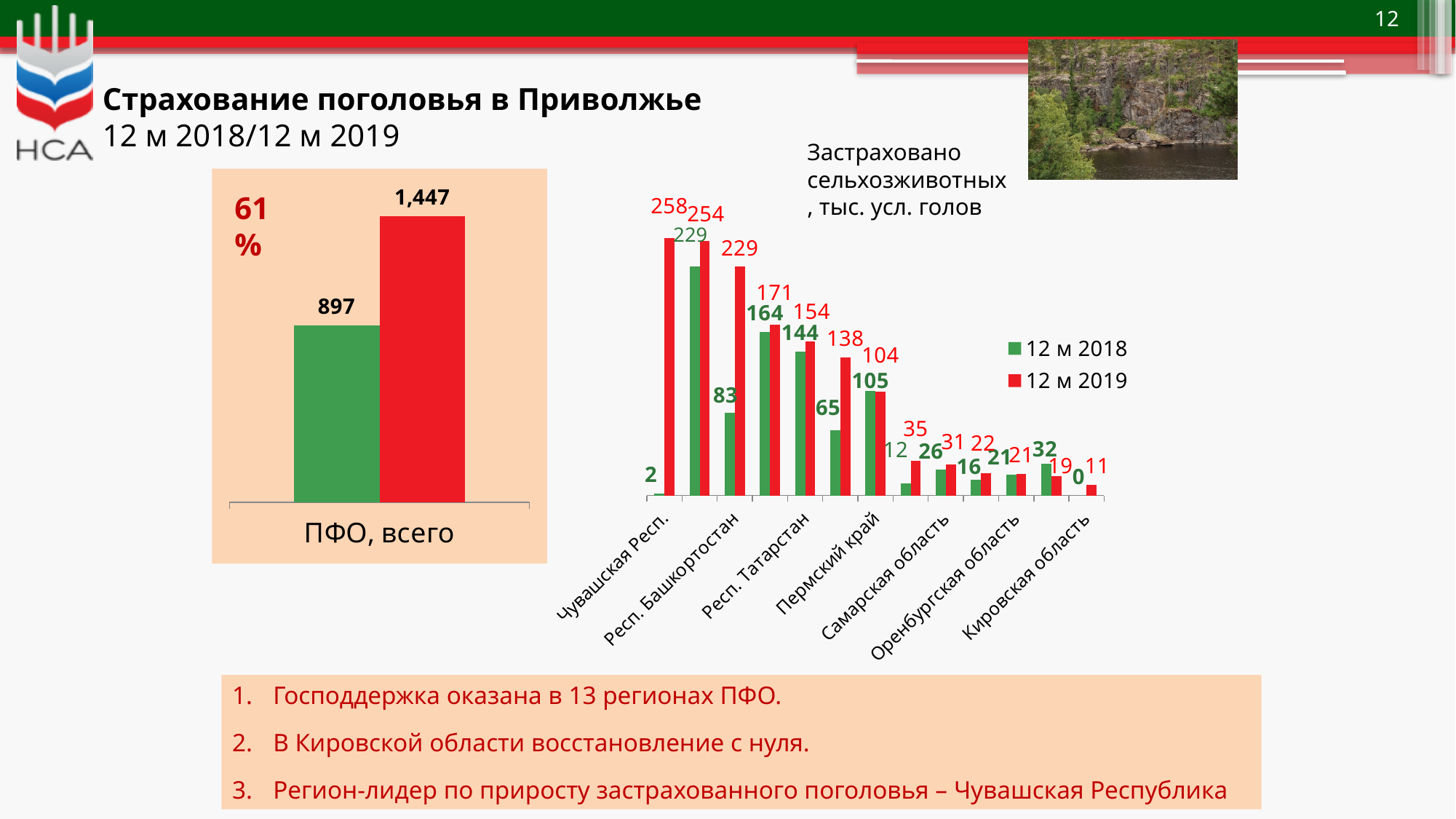
In the left chart (ПФО, всего), what is the value for 12 м 2018? 897 In the left chart (ПФО, всего), what is the value for 12 м 2019? 1,447 What percentage is printed in the left chart (ПФО, всего)? 61 % In the right chart (Застраховано сельхозживотных), what are the two legend entries? 12 м 2018 and 12 м 2019 In the left chart (ПФО, всего), what is the difference between the 12 м 2019 value and the 12 м 2018 value? 550 In the left chart (ПФО, всего), which is larger: the 12 м 2018 value or the 12 м 2019 value? 12 м 2019 What kind of chart is the right chart (Застраховано сельхозживотных)? bar chart In the right chart (Застраховано сельхозживотных), what is the 12 м 2018 value for Кировская область? 0 In the right chart (Застраховано сельхозживотных), what is the 12 м 2018 value for Чувашская Респ.? 2 In the right chart (Застраховано сельхозживотных), which region has the highest 12 м 2019 value? Чувашская Респ. How many series does the legend of the right chart (Застраховано сельхозживотных) list? 2 In the right chart (Застраховано сельхозживотных), what is the 12 м 2019 value for Чувашская Респ.? 258